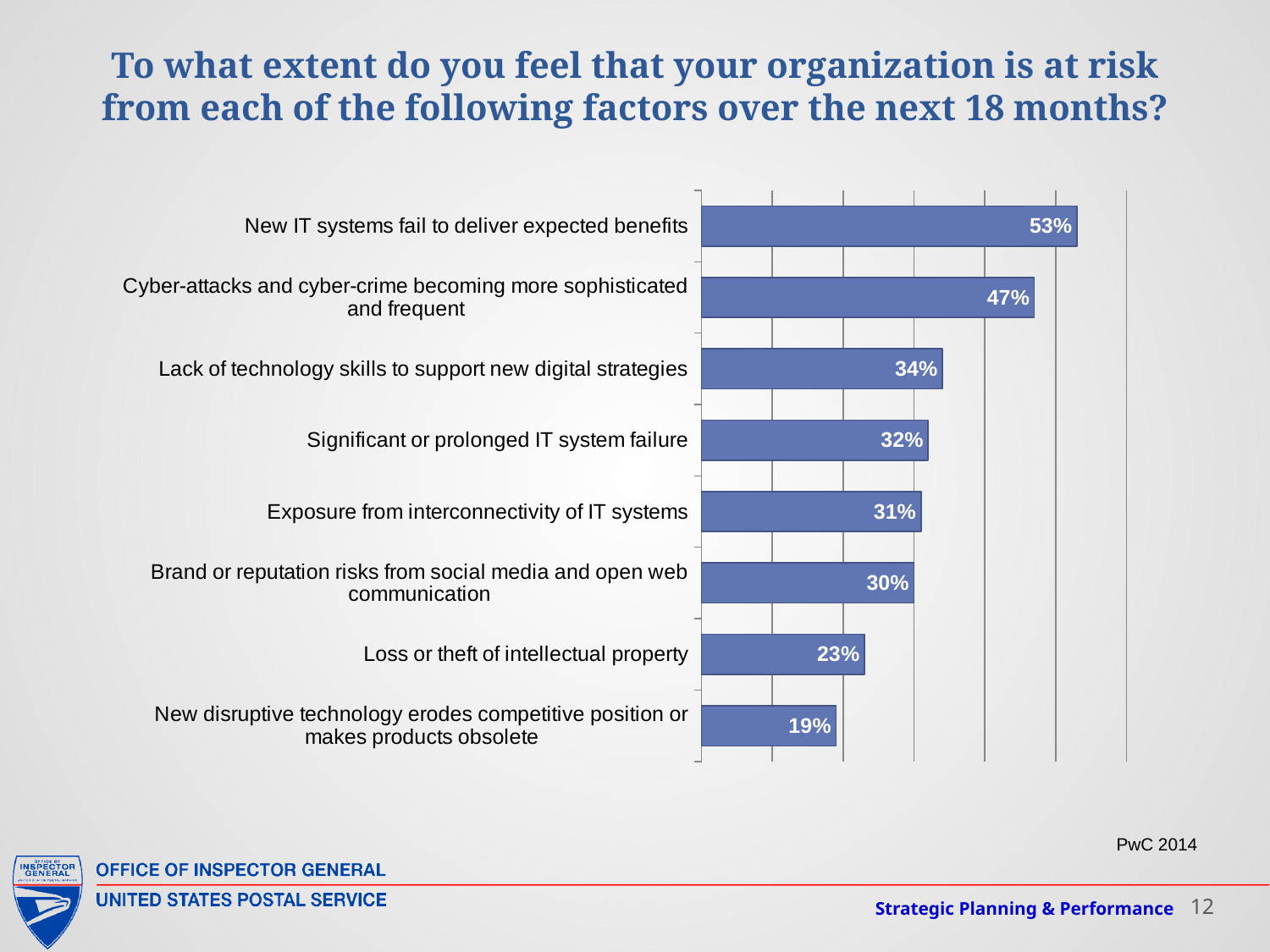
How many factors are shown in the chart? 8 What type of chart is shown on the slide? Bar chart Which factor has the highest value in the chart? New IT systems fail to deliver expected benefits Which factor has the lowest value in the chart? New disruptive technology erodes competitive position or makes products obsolete Do the values increase or decrease from the top bar to the bottom bar? Decrease What is the difference between the values for 'Lack of technology skills to support new digital strategies' and 'New disruptive technology erodes competitive position or makes products obsolete'? 15% Which has a larger value: 'Significant or prolonged IT system failure' or 'Brand or reputation risks from social media and open web communication'? Significant or prolonged IT system failure What is the value for 'Loss or theft of intellectual property'? 23% What is the difference between the values for 'New IT systems fail to deliver expected benefits' and 'Cyber-attacks and cyber-crime becoming more sophisticated and frequent'? 6% What percentage of respondents cited 'New IT systems fail to deliver expected benefits' as a risk? 53% What is the value for 'Cyber-attacks and cyber-crime becoming more sophisticated and frequent'? 47% What source is cited for the chart data? PwC 2014